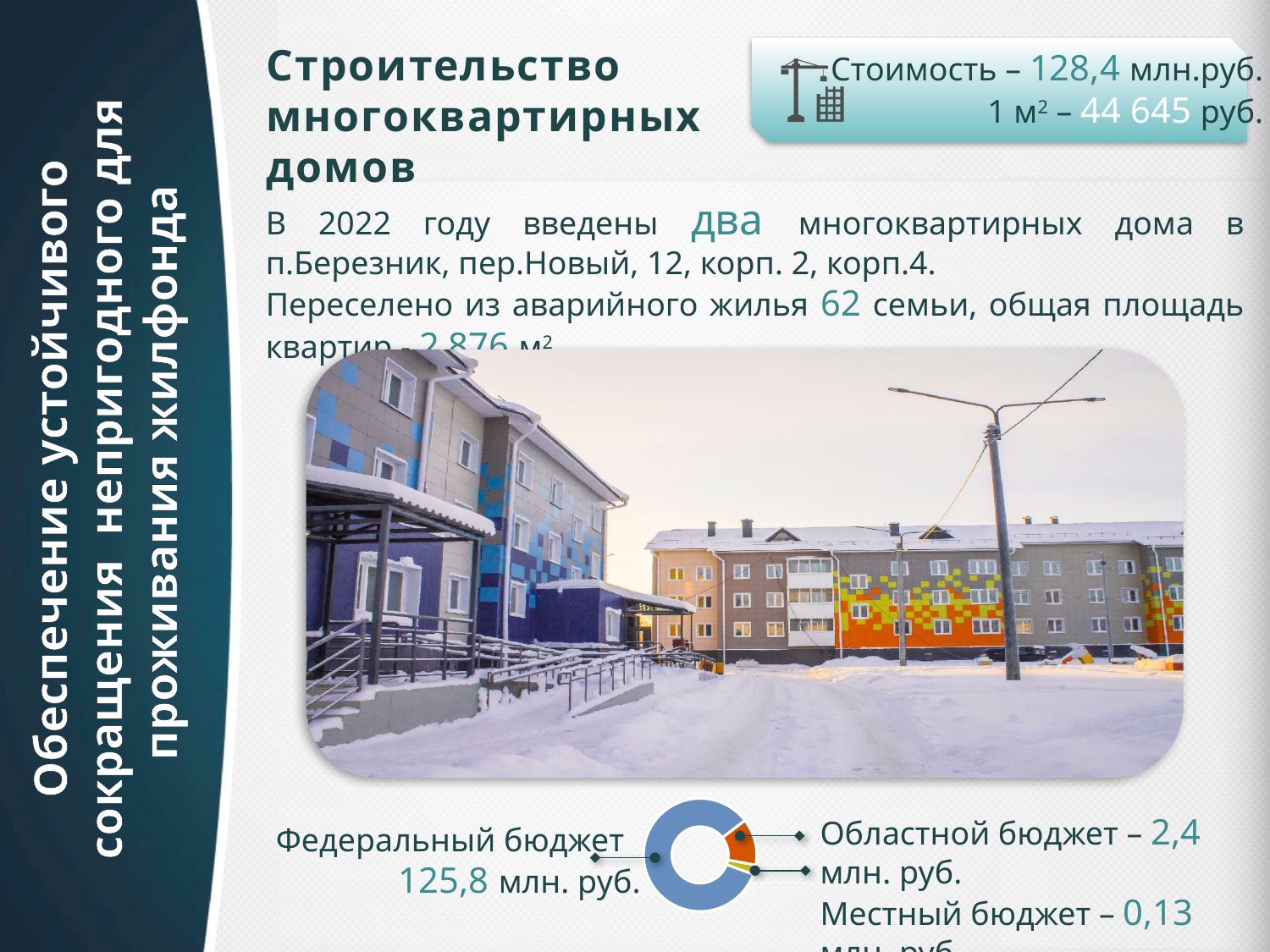
Which is larger in the pie chart: Областной бюджет or Местный бюджет? Областной бюджет Which budget source has the largest share in the pie chart? Федеральный бюджет What is the value for Областной бюджет in the pie chart? 2,4 млн. руб. What is the difference between Областной бюджет and Местный бюджет in the pie chart? 2,27 млн. руб. What kind of chart is shown at the bottom of the slide? Pie (donut) chart What is the value for Местный бюджет in the pie chart? 0,13 млн. руб. What is the value for Федеральный бюджет in the pie chart? 125,8 млн. руб. What colour represents Федеральный бюджет in the pie chart? Blue How many budget sources are shown in the pie chart at the bottom of the slide? 3 Which budget source has the smallest share in the pie chart? Местный бюджет What colour represents Областной бюджет in the pie chart? Orange What is the difference between Федеральный бюджет and Областной бюджет in the pie chart? 123,4 млн. руб.